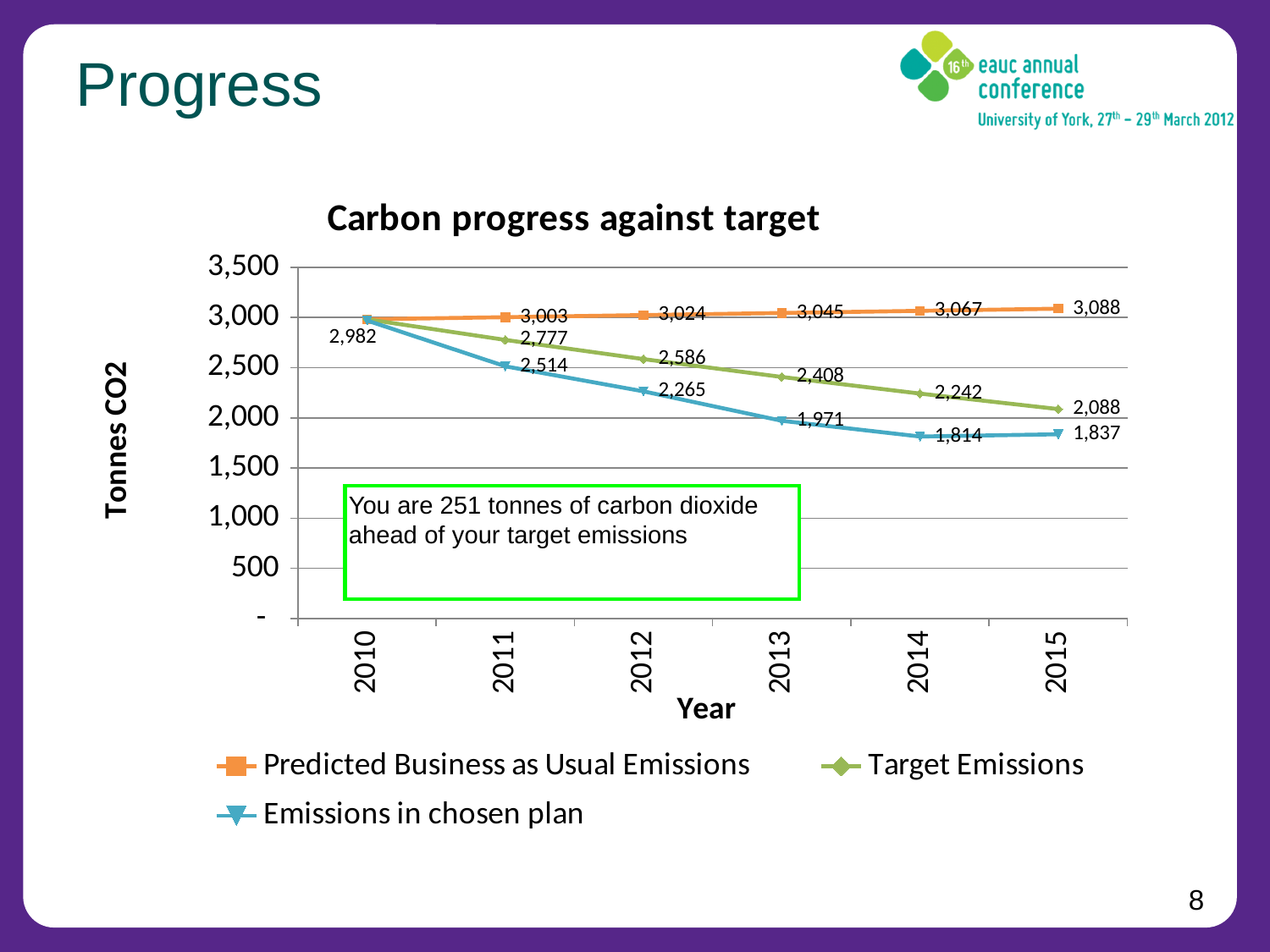
What is the value of Target Emissions in 2013? 2,408 What type of chart is shown on the slide? line chart What is the difference between Predicted Business as Usual Emissions and Target Emissions in 2015? 1,000 What is the difference between Target Emissions and Emissions in chosen plan in 2015? 251 Which is larger in 2014: Target Emissions or Emissions in chosen plan? Target Emissions What is the title of the chart? Carbon progress against target Do the Target Emissions values rise or fall from 2010 to 2015? fall What is the value of Emissions in chosen plan in 2012? 2,265 How many series does the legend list? 3 What is the value of Predicted Business as Usual Emissions in 2015? 3,088 In which year is the Emissions in chosen plan series at its lowest? 2014 How many years are plotted on the x axis? 6